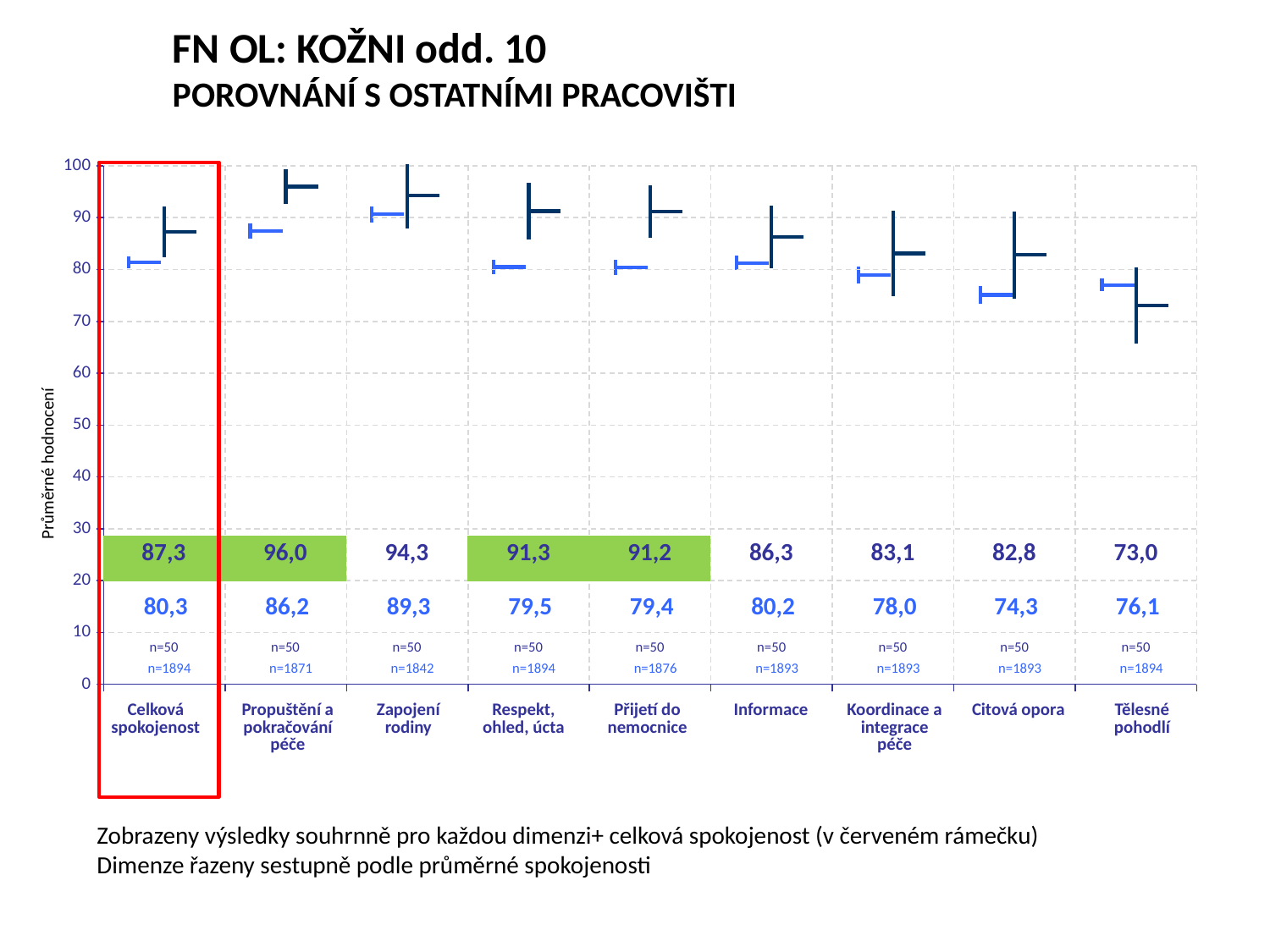
What is the dark blue (upper) value shown for Celková spokojenost? 87,3 How many categories are shown along the x axis? 9 Which category has the highest light blue (lower) value? Zapojení rodiny Which category has the highest dark blue (upper) value? Propuštění a pokračování péče What is the label of the y axis? Průměrné hodnocení Which category has the lowest dark blue (upper) value? Tělesné pohodlí Which is larger for Informace: the dark blue (upper) value or the light blue (lower) value? the dark blue (upper) value, 86,3 What is the light blue (lower) value shown for Citová opora? 74,3 What is the difference between the dark blue and light blue values for Propuštění a pokračování péče? 9,8 What is the dark blue (upper) value shown for Zapojení rodiny? 94,3 What sample size (n) is printed in the upper row for each category? n=50 What is the light blue (lower) value shown for Celková spokojenost? 80,3